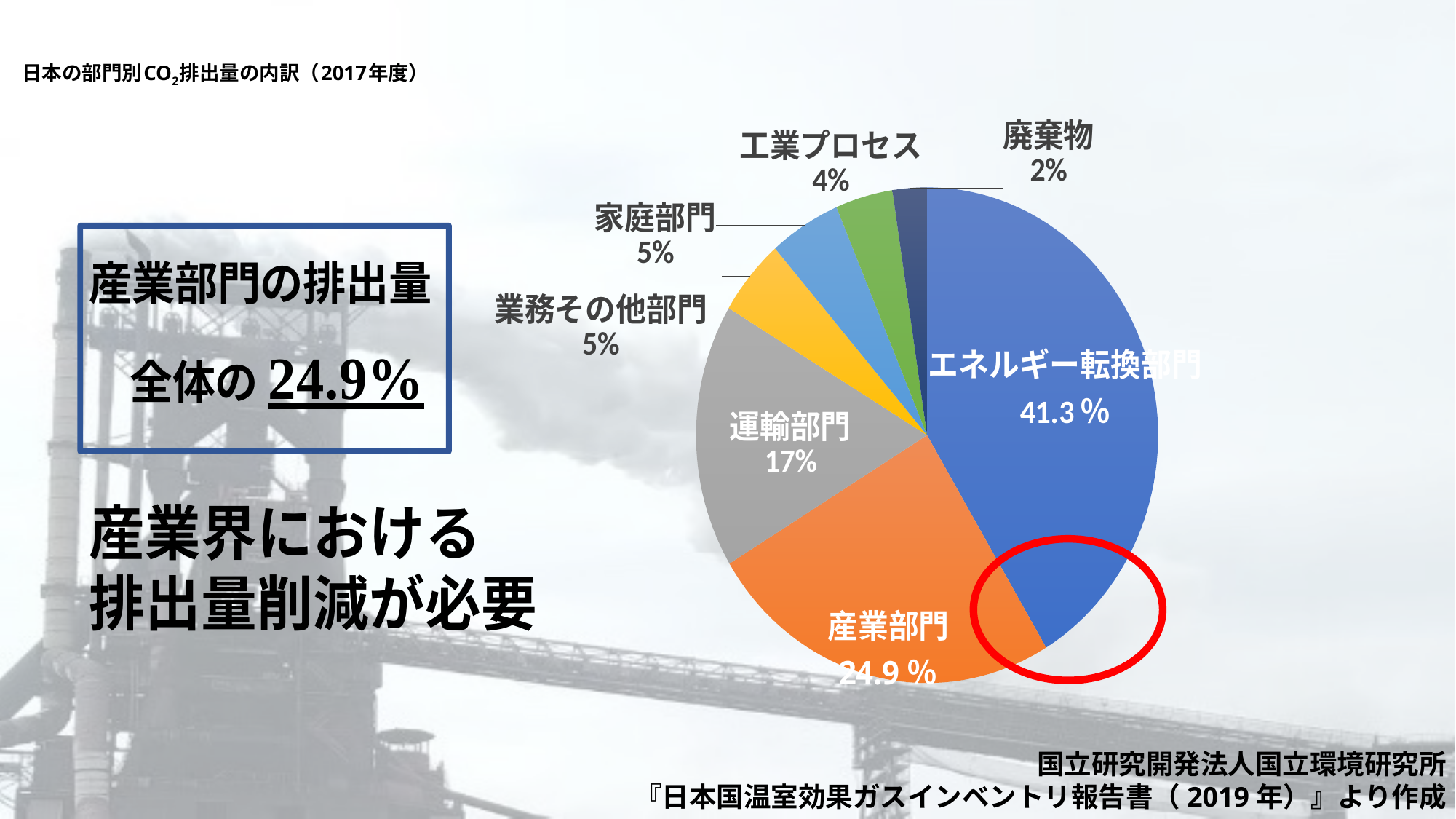
What share of the pie does エネルギー転換部門 account for? 41.3% Which sector has the largest share of the pie? エネルギー転換部門 What is the difference between the shares of 運輸部門 and 業務その他部門? 12% What is the difference between the shares of エネルギー転換部門 and 産業部門? 16.4% How many sectors (slices) are shown in the pie chart? 7 What is the title of the chart? 日本の部門別CO2排出量の内訳（2017年度） Which is larger, the share of 運輸部門 or the share of 家庭部門? 運輸部門 Which sector has the smallest share of the pie? 廃棄物 What kind of chart is shown on the slide? Pie chart What is the value shown for 工業プロセス? 4% What is the value shown for 運輸部門? 17% What is the value shown for 産業部門? 24.9%